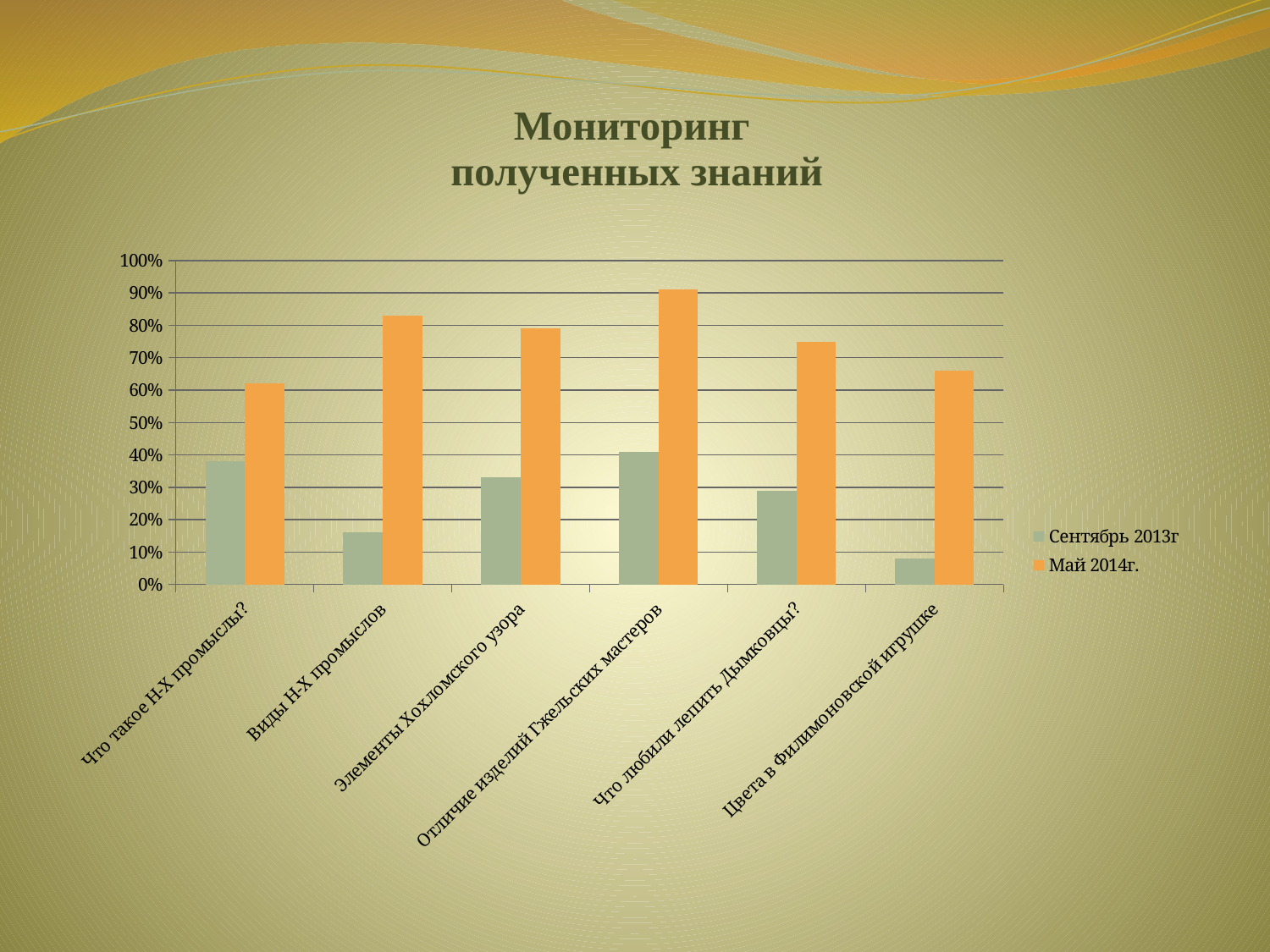
Is the Май 2014г. value for Виды Н-Х промыслов greater or less than 70%? greater Which category has the highest value for Май 2014г.? Отличие изделий Гжельских мастеров For Что любили лепить Дымковцы?, which series has the larger value, Сентябрь 2013г or Май 2014г.? Май 2014г. Which series is shown in orange in the legend? Май 2014г. What is the title of the chart? Мониторинг полученных знаний How many categories are shown on the x axis of the chart? 6 Is the Сентябрь 2013г value for Цвета в Филимоновской игрушке greater or less than 10%? less How many series does the legend list? 2 Which category has the lowest value for Сентябрь 2013г? Цвета в Филимоновской игрушке Is the Май 2014г. value for Что такое Н-Х промыслы? greater or less than 50%? greater What kind of chart is shown on the slide? bar chart